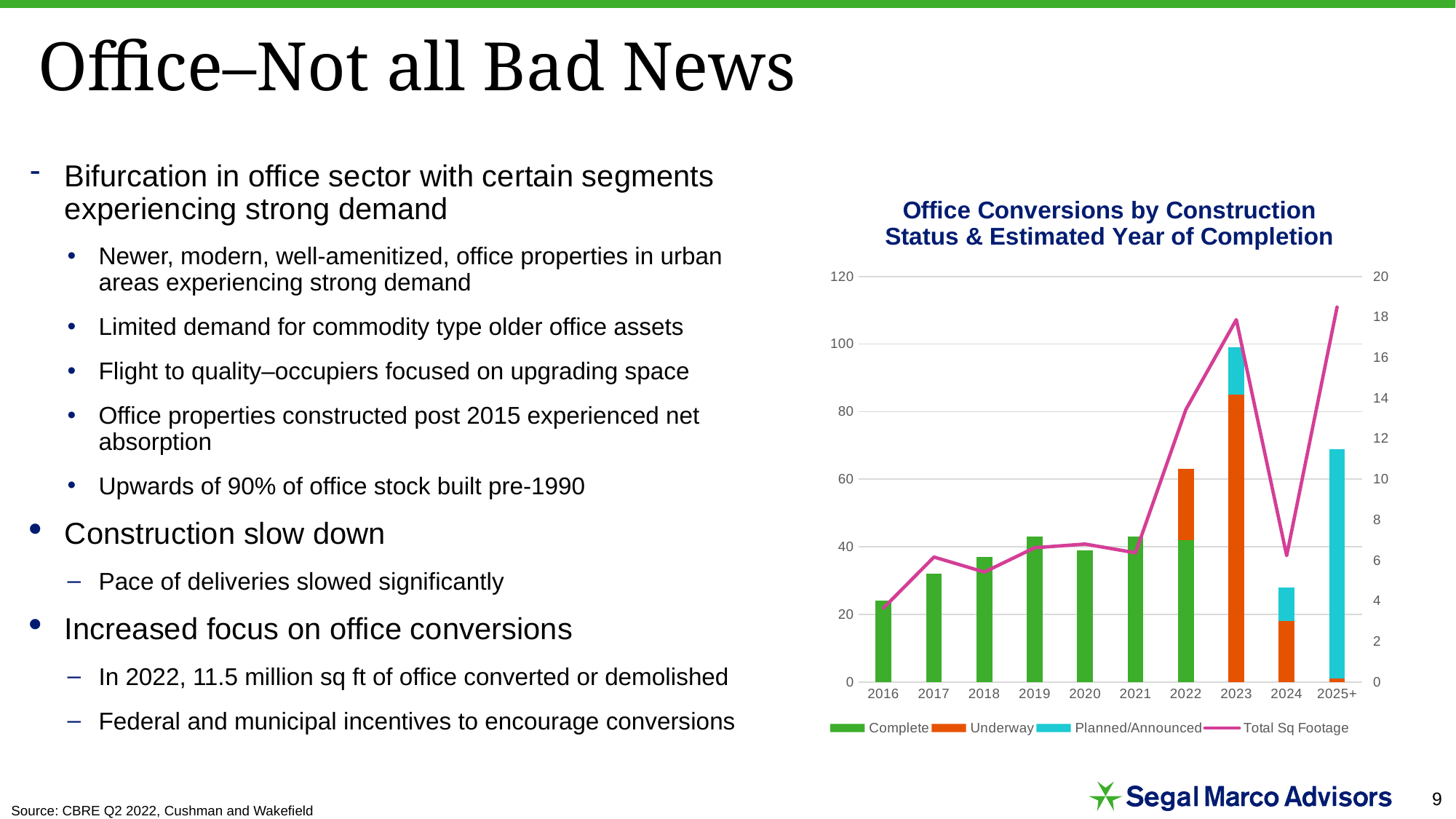
What is the title of the chart? Office Conversions by Construction Status & Estimated Year of Completion In which year is the Total Sq Footage line at its lowest point? 2016 Does the Total Sq Footage line rise or fall from 2023 to 2024? fall How many series does the chart legend list? 4 Is the bar value for 2016 greater or less than 40? less What kind of chart is shown on the slide? Combination stacked bar and line chart Which series is plotted as a line rather than bars? Total Sq Footage Which year has the tallest stacked bar? 2023 Is the stacked bar value for 2025+ greater or less than 60? greater How many year categories are shown on the x axis of the chart? 10 Is the total stacked bar value for 2023 greater or less than 80? greater Which bar is taller, 2019 or 2017? 2019